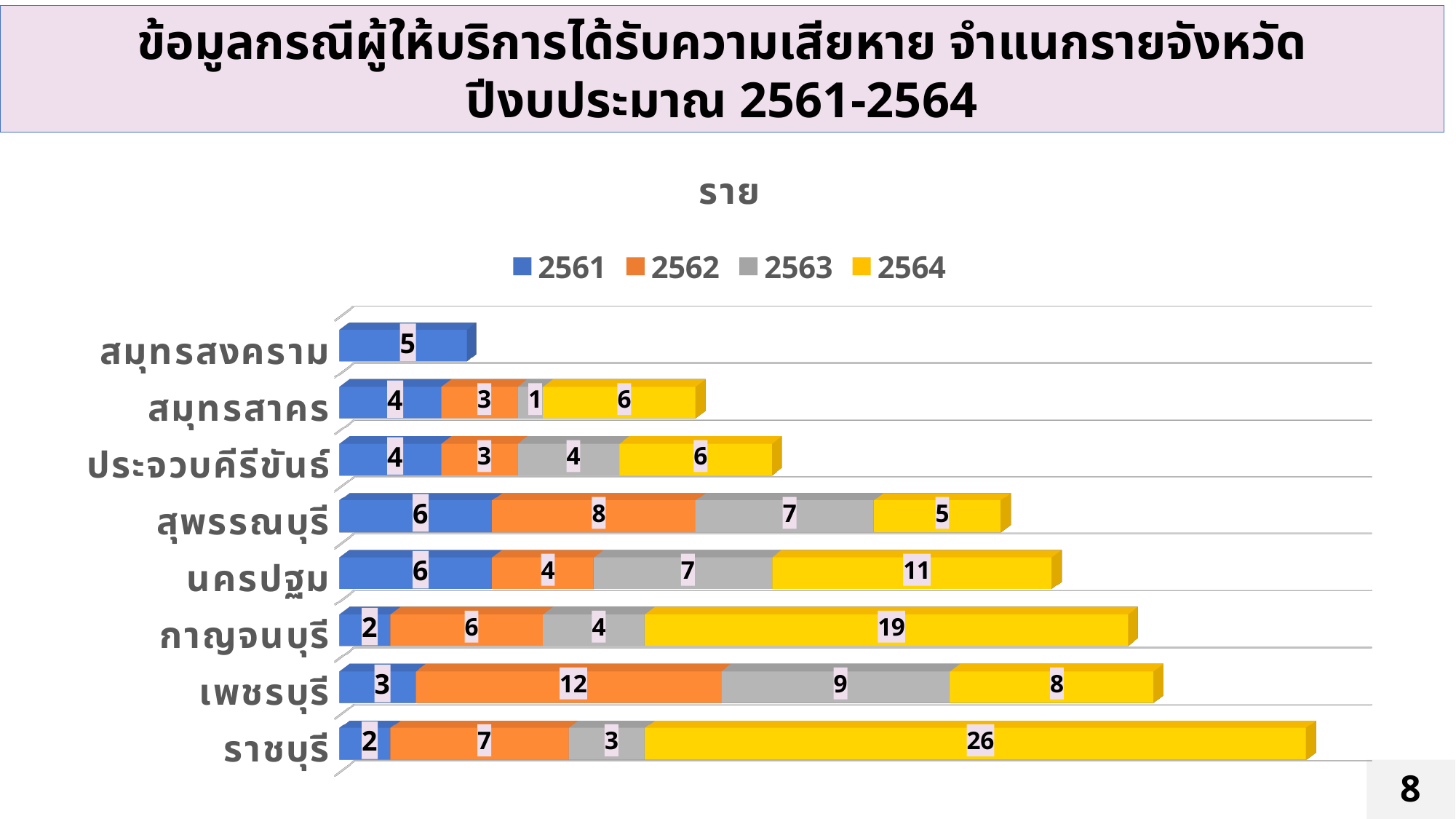
Which is larger: the 2562 value for สุพรรณบุรี or the 2562 value for ราชบุรี? สุพรรณบุรี What is the value for นครปฐม in the 2563 series? 7 How many provinces are shown on the chart? 8 What kind of chart is shown on the slide? Stacked bar chart Which province has the lowest value in the 2563 series? สมุทรสาคร What is the total of the stacked bar for ราชบุรี? 38 What is the difference between the 2564 values for กาญจนบุรี and นครปฐม? 8 What is the value for เพชรบุรี in the 2562 series? 12 What is the total of the stacked bar for เพชรบุรี? 32 Which province has the highest value in the 2564 series? ราชบุรี What is the value for ราชบุรี in the 2564 series? 26 How many series does the legend list? 4